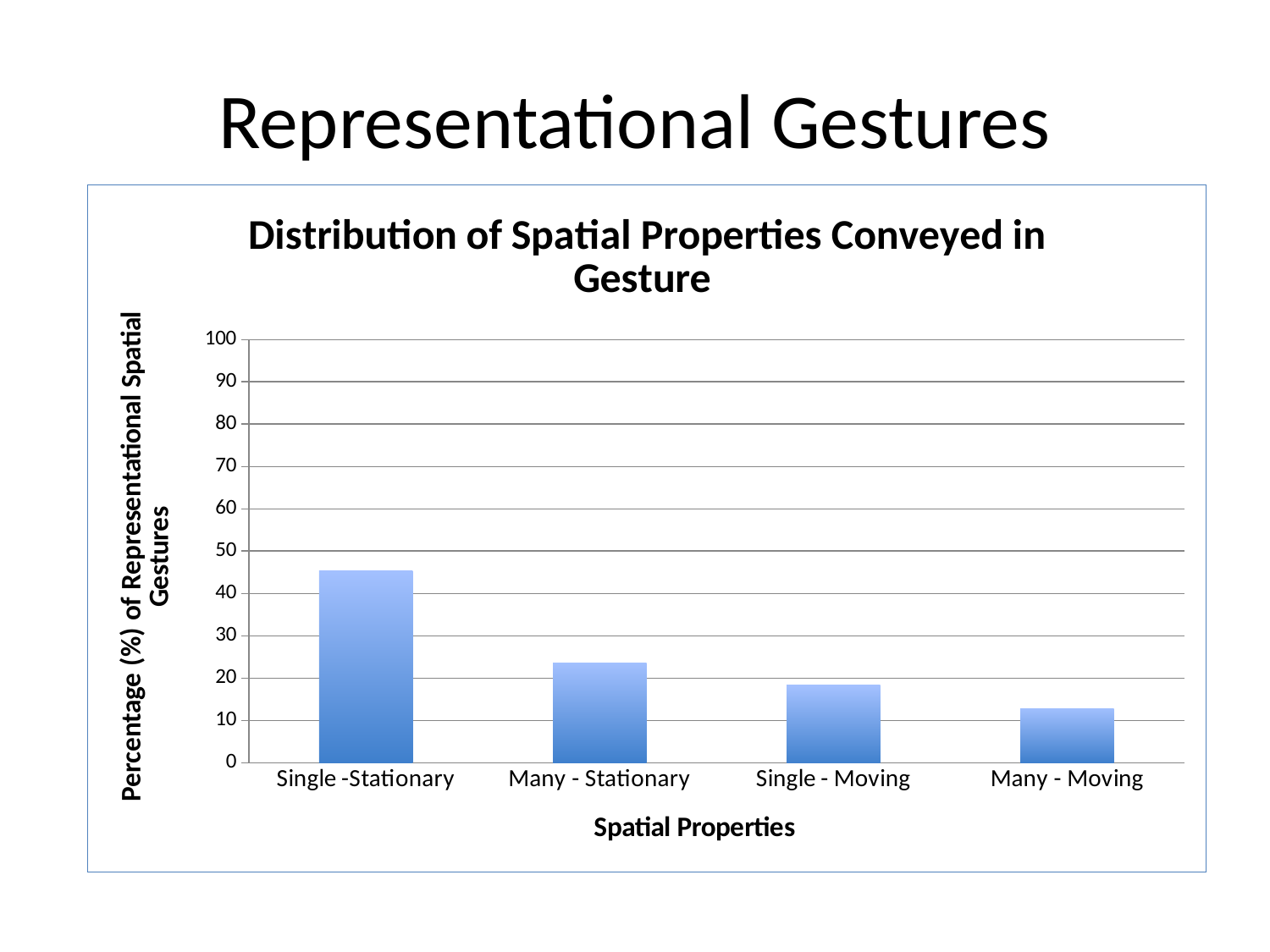
Do the values rise or fall moving from left to right along the x axis? fall Which is larger, the value for Many - Stationary or the value for Single - Moving? Many - Stationary What kind of chart is shown on the slide? bar chart Which category has the highest percentage of representational spatial gestures? Single -Stationary Is the value for Single -Stationary greater or less than 40? greater Is the value for Many - Stationary greater or less than 20? greater Is the value for Many - Moving greater or less than 10? greater Which category has the lowest percentage of representational spatial gestures? Many - Moving How many categories are shown on the x axis of the chart? 4 What is the title of the chart? Distribution of Spatial Properties Conveyed in Gesture